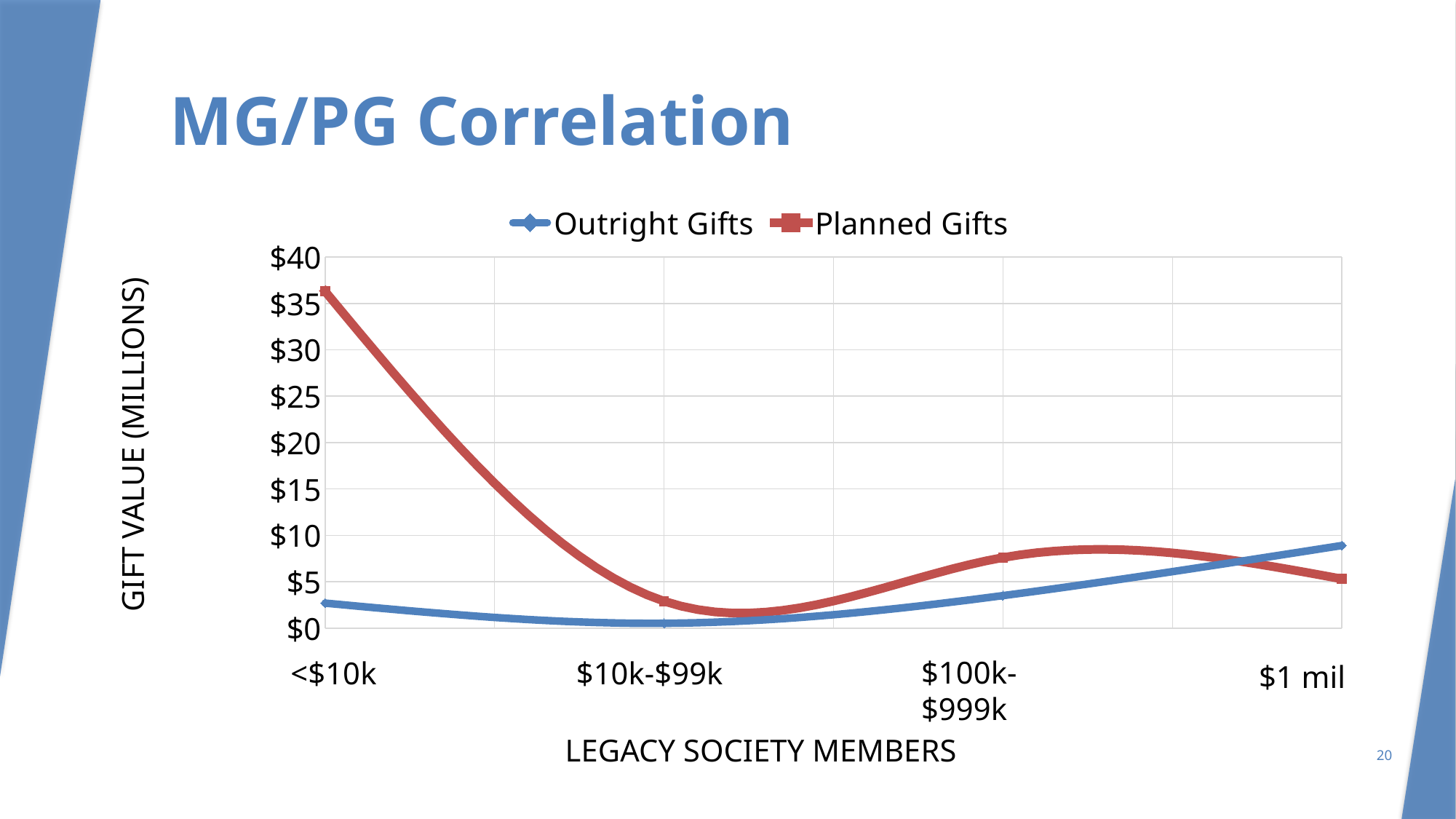
How many categories are shown on the x axis? 4 At <$10k, which series has the larger value, Outright Gifts or Planned Gifts? Planned Gifts Is the Outright Gifts value for $1 mil greater or less than $5? greater How many series does the legend list? 2 Is the Planned Gifts value for $10k-$99k greater or less than $5? less At $1 mil, which series has the larger value, Outright Gifts or Planned Gifts? Outright Gifts For which category is the Outright Gifts value lowest? $10k-$99k What is the title of the y axis? GIFT VALUE (MILLIONS) For which category is the Planned Gifts value highest? <$10k Is the Planned Gifts value for <$10k greater or less than $30? greater For which category is the Outright Gifts value highest? $1 mil What kind of chart is shown on the slide? Line chart